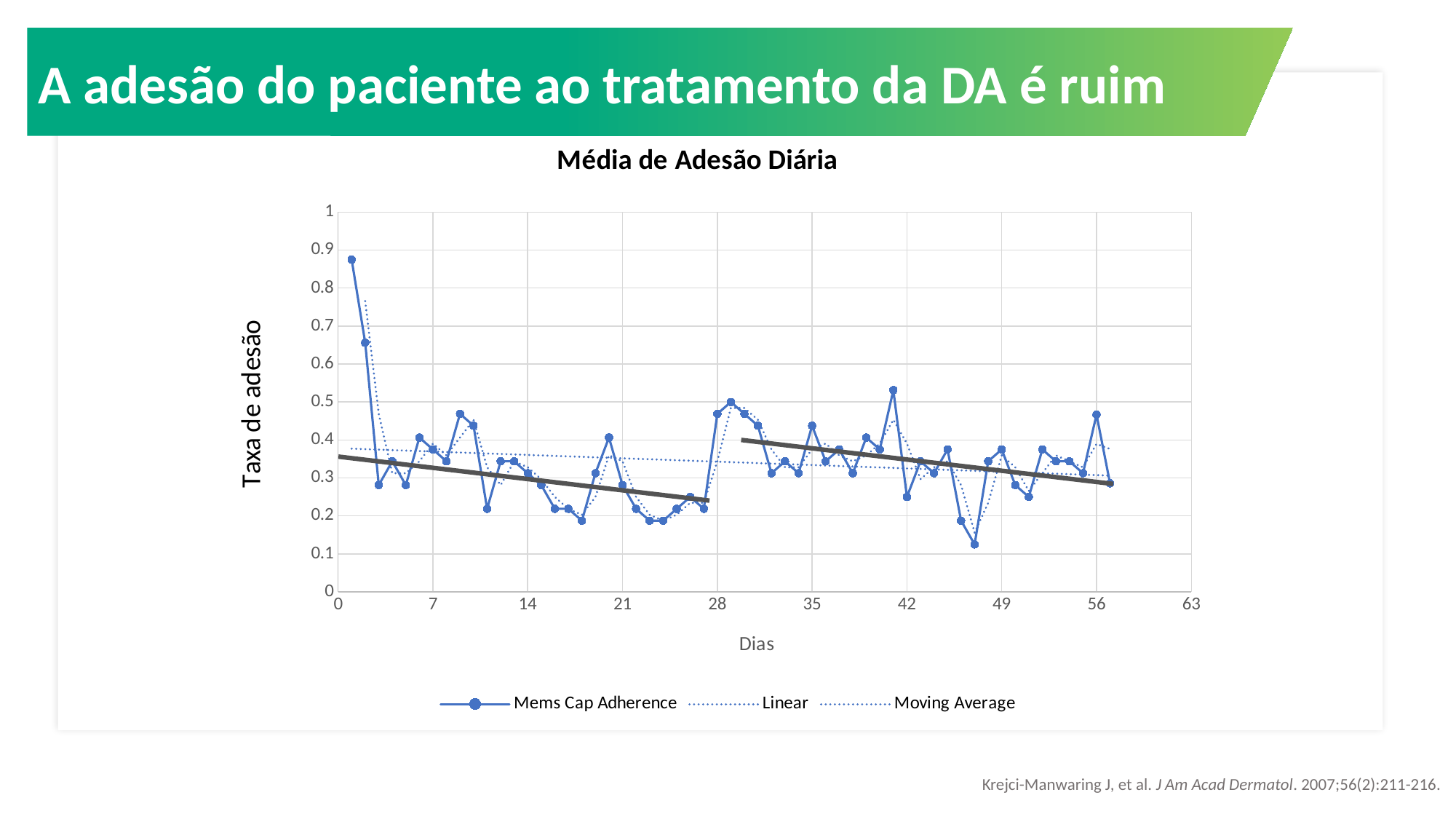
Which is larger, the first Mems Cap Adherence value or the last one on the chart? the first Which is larger, the Mems Cap Adherence value on day 1 or on day 2? day 1 Is the Mems Cap Adherence value on day 2 greater or less than 0.6? greater Is the Mems Cap Adherence value on day 41 greater or less than 0.5? greater Do the Mems Cap Adherence values generally rise or fall as the days increase? fall What label is shown on the vertical axis of the chart? Taxa de adesão On which day does Mems Cap Adherence reach its highest value? day 1 What is the title of the chart? Média de Adesão Diária Is the lowest Mems Cap Adherence value on the chart greater or less than 0.2? less What kind of chart is shown on the slide? line chart How many series does the legend list? 3